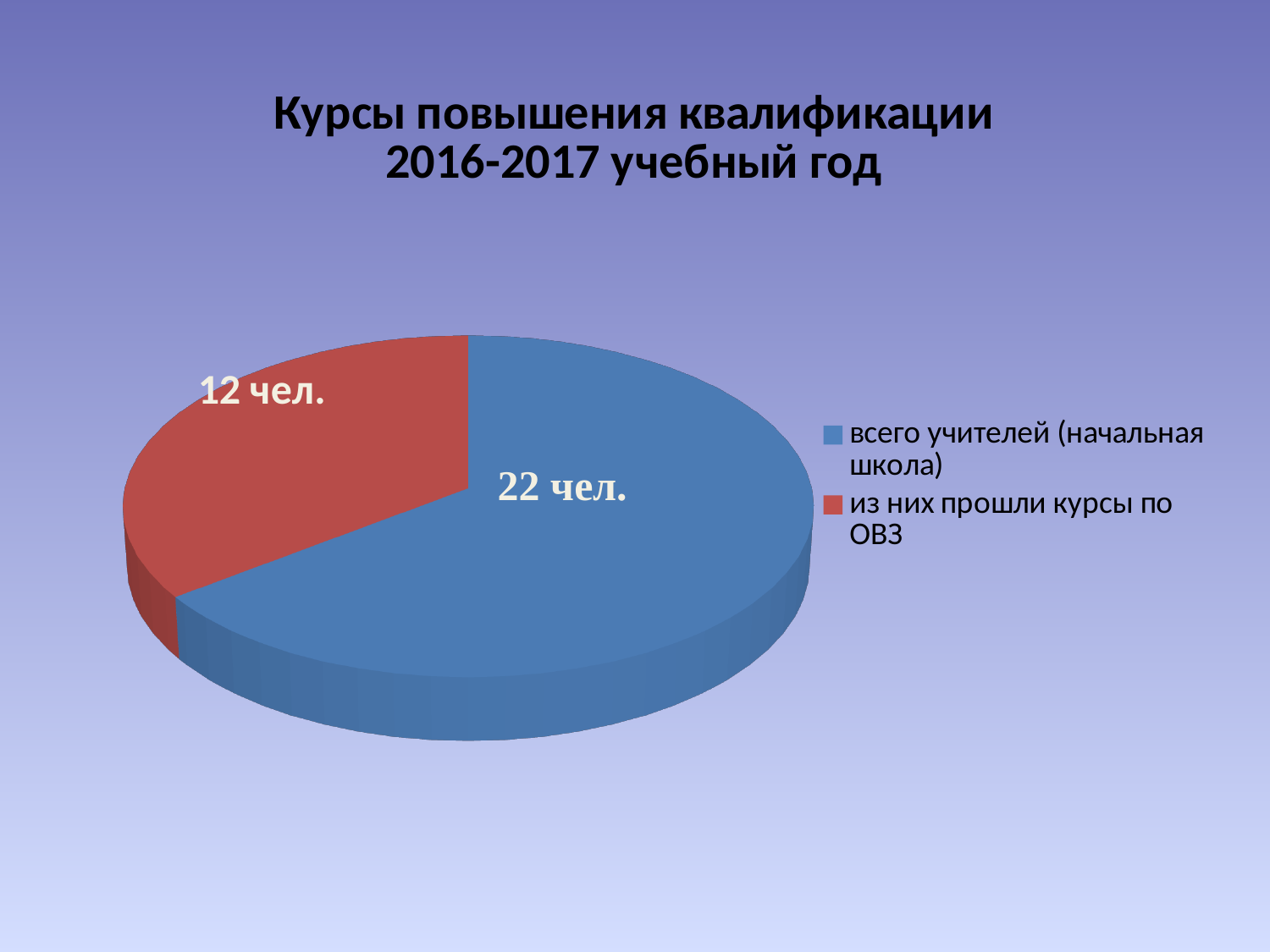
What value is shown for "всего учителей (начальная школа)"? 22 чел. Which slice of the pie is the largest? всего учителей (начальная школа) What is the sum of the two values shown on the pie chart? 34 чел. How many entries does the legend list? 2 Which is larger: the value for "всего учителей (начальная школа)" or the value for "из них прошли курсы по ОВЗ"? всего учителей (начальная школа) What value is shown for "из них прошли курсы по ОВЗ"? 12 чел. How many slices does the pie chart have? 2 What is the title of the chart on the slide? Курсы повышения квалификации 2016-2017 учебный год Which slice of the pie is the smallest? из них прошли курсы по ОВЗ What type of chart is shown on the slide? Pie chart What is the difference between the value for "всего учителей (начальная школа)" and the value for "из них прошли курсы по ОВЗ"? 10 чел. What colour is the slice for "из них прошли курсы по ОВЗ"? Red